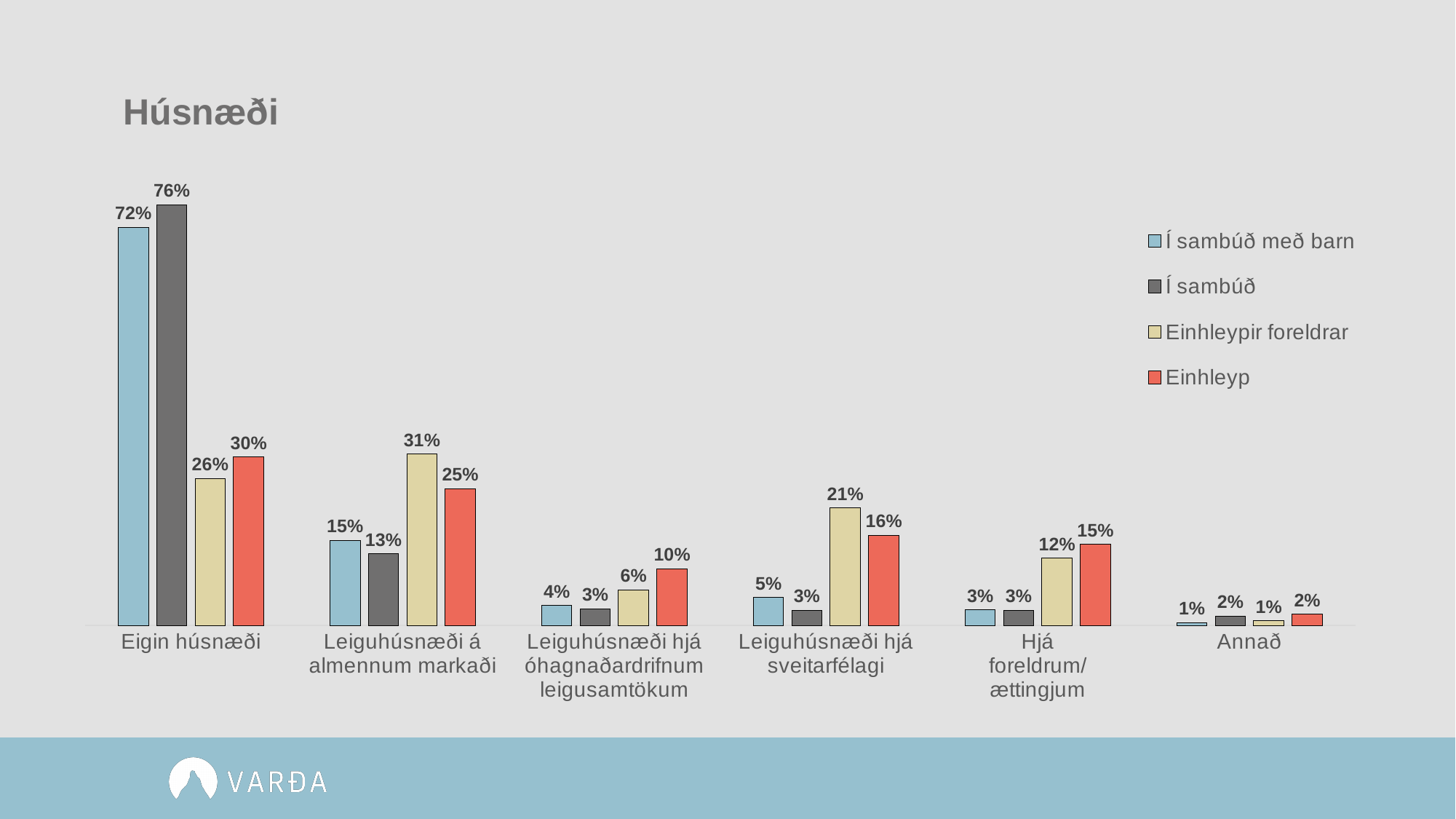
What is the value for Einhleyp in the Leiguhúsnæði hjá sveitarfélagi category? 16% What is the value for Í sambúð in the Eigin húsnæði category? 76% What is the value for Í sambúð með barn in the Hjá foreldrum/ættingjum category? 3% Which series has the lowest value in the Leiguhúsnæði á almennum markaði category? Í sambúð Which is larger in the Leiguhúsnæði hjá óhagnaðardrifnum leigusamtökum category: Einhleyp or Einhleypir foreldrar? Einhleyp What is the title of the chart? Húsnæði How many series does the legend list? 4 What is the difference between the Í sambúð and Í sambúð með barn values in the Eigin húsnæði category? 4% How many categories are shown on the x axis? 6 What is the value for Einhleypir foreldrar in the Leiguhúsnæði á almennum markaði category? 31% What kind of chart is shown on the slide? Bar chart Which series has the highest value in the Leiguhúsnæði hjá sveitarfélagi category? Einhleypir foreldrar